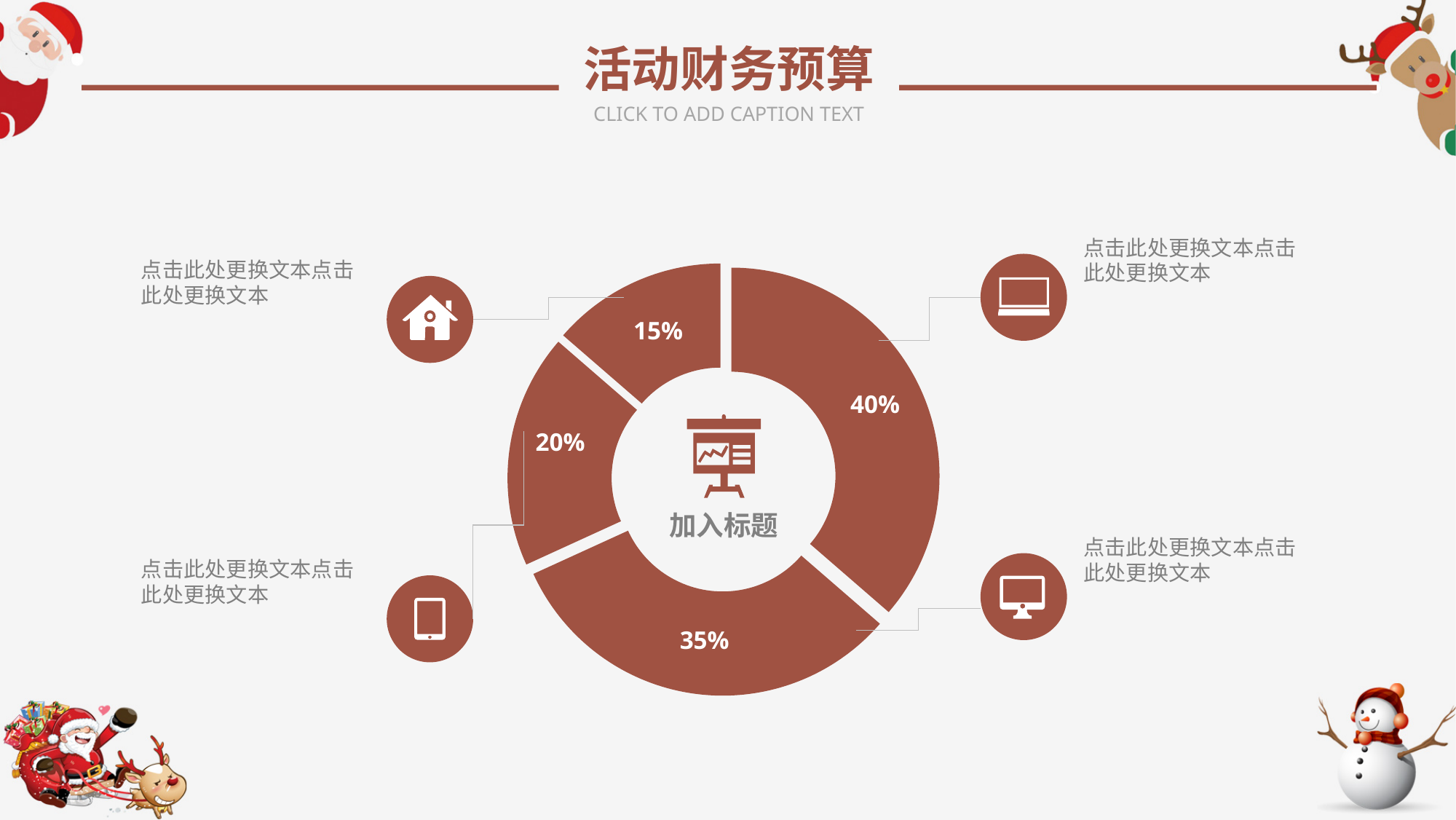
What value is shown on the slice connected to the laptop icon? 40% How many slices does the donut chart have? 4 What is the difference between the largest slice (40%) and the smallest slice (15%)? 25% What value is shown on the slice connected to the tablet/phone icon? 20% What value is shown on the slice connected to the house icon? 15% What text appears in the centre of the donut chart? 加入标题 What is the largest value shown on the donut chart? 40% Which is larger, the slice labelled 35% or the slice labelled 20%? 35% What is the total of the four slice values shown on the donut chart? 110% What is the smallest value shown on the donut chart? 15% What kind of chart is shown on the slide? Donut (pie) chart What value is shown on the slice connected to the desktop monitor icon? 35%